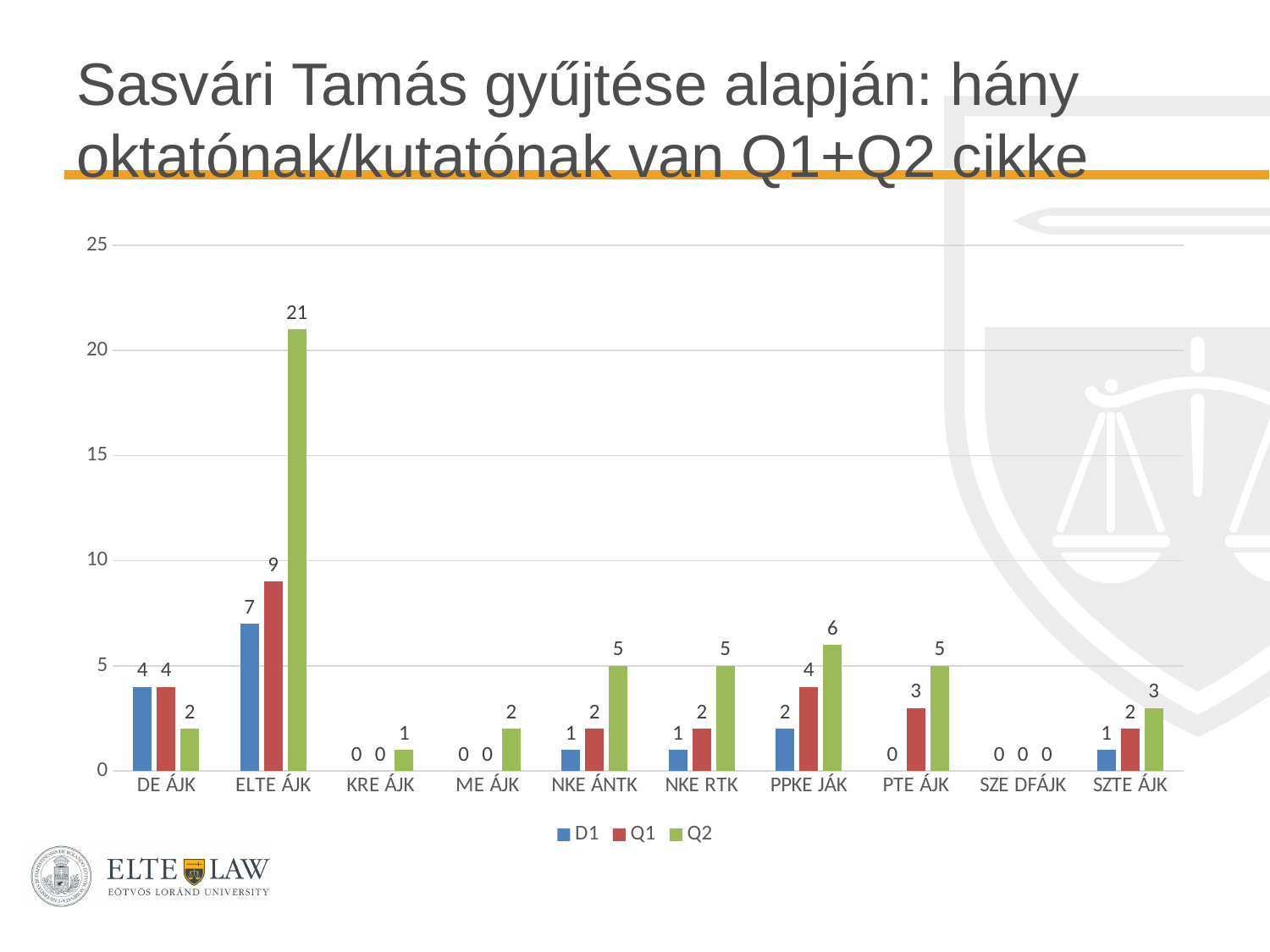
Which category has the highest Q2 value? ELTE ÁJK Which series is shown in green in the legend? Q2 Is the Q2 value for ELTE ÁJK greater or less than 20? greater What is the difference between the Q2 and Q1 values for ELTE ÁJK? 12 How many categories are shown on the x axis? 10 What kind of chart is shown on the slide? bar chart What is the D1 value for PPKE JÁK? 2 How many series does the legend list? 3 What is the Q1 value for PTE ÁJK? 3 Which is larger, the Q2 value for PPKE JÁK or the Q2 value for PTE ÁJK? PPKE JÁK Which category has the highest D1 value? ELTE ÁJK What is the Q2 value for ELTE ÁJK? 21